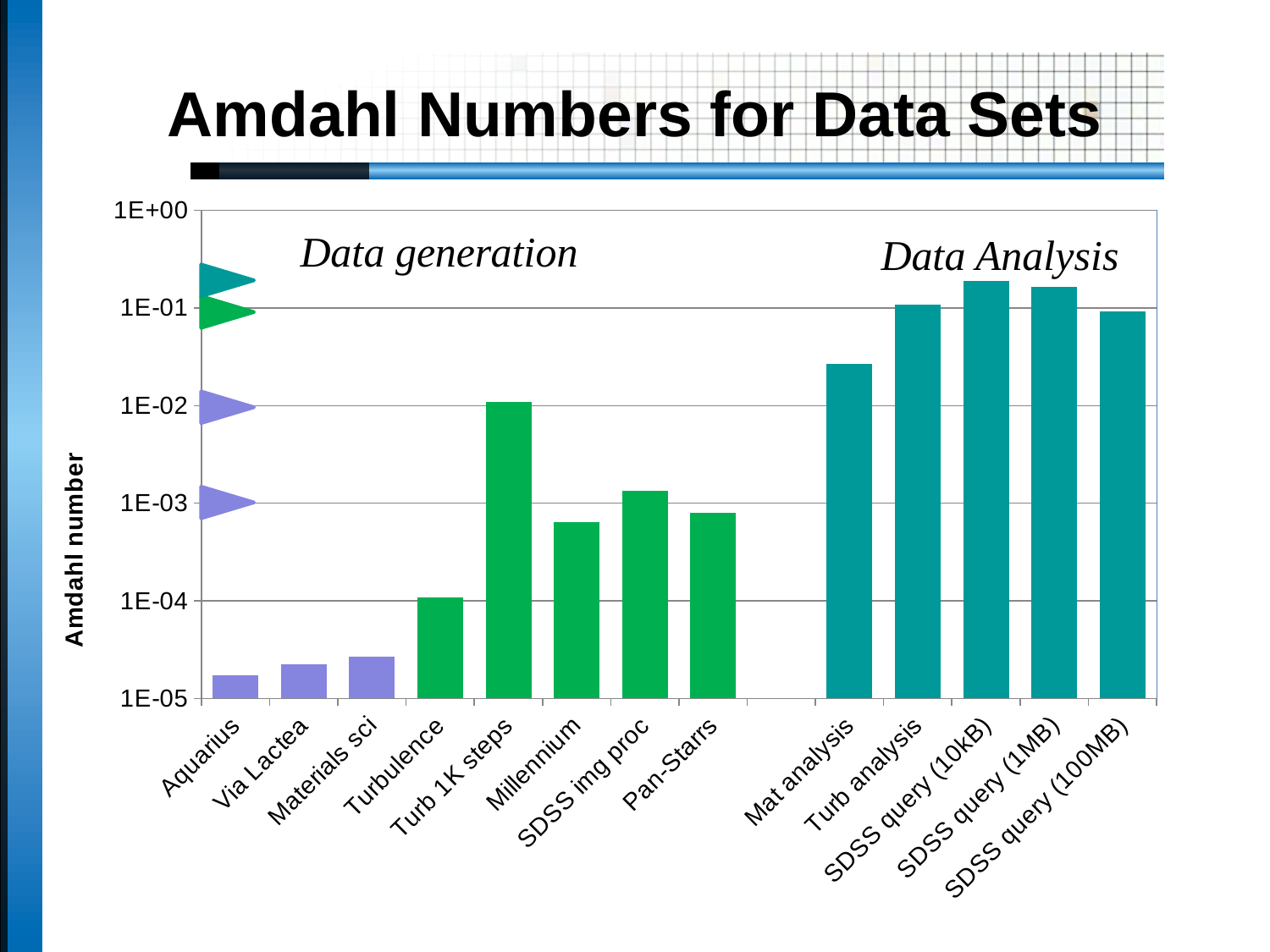
Which category has the highest Amdahl number? SDSS query (10kB) How many categories are plotted along the x axis? 13 Is the value for Mat analysis greater or less than 1E-02? greater Is the value for Millennium greater or less than 1E-03? less Which category has the lowest Amdahl number? Aquarius Is the value for SDSS img proc greater or less than 1E-03? greater What is the label on the y axis of the chart? Amdahl number Which is larger, the value for Turb 1K steps or the value for Millennium? Turb 1K steps Which is larger, the value for Pan-Starrs or the value for Mat analysis? Mat analysis What kind of chart is shown on the slide? bar chart